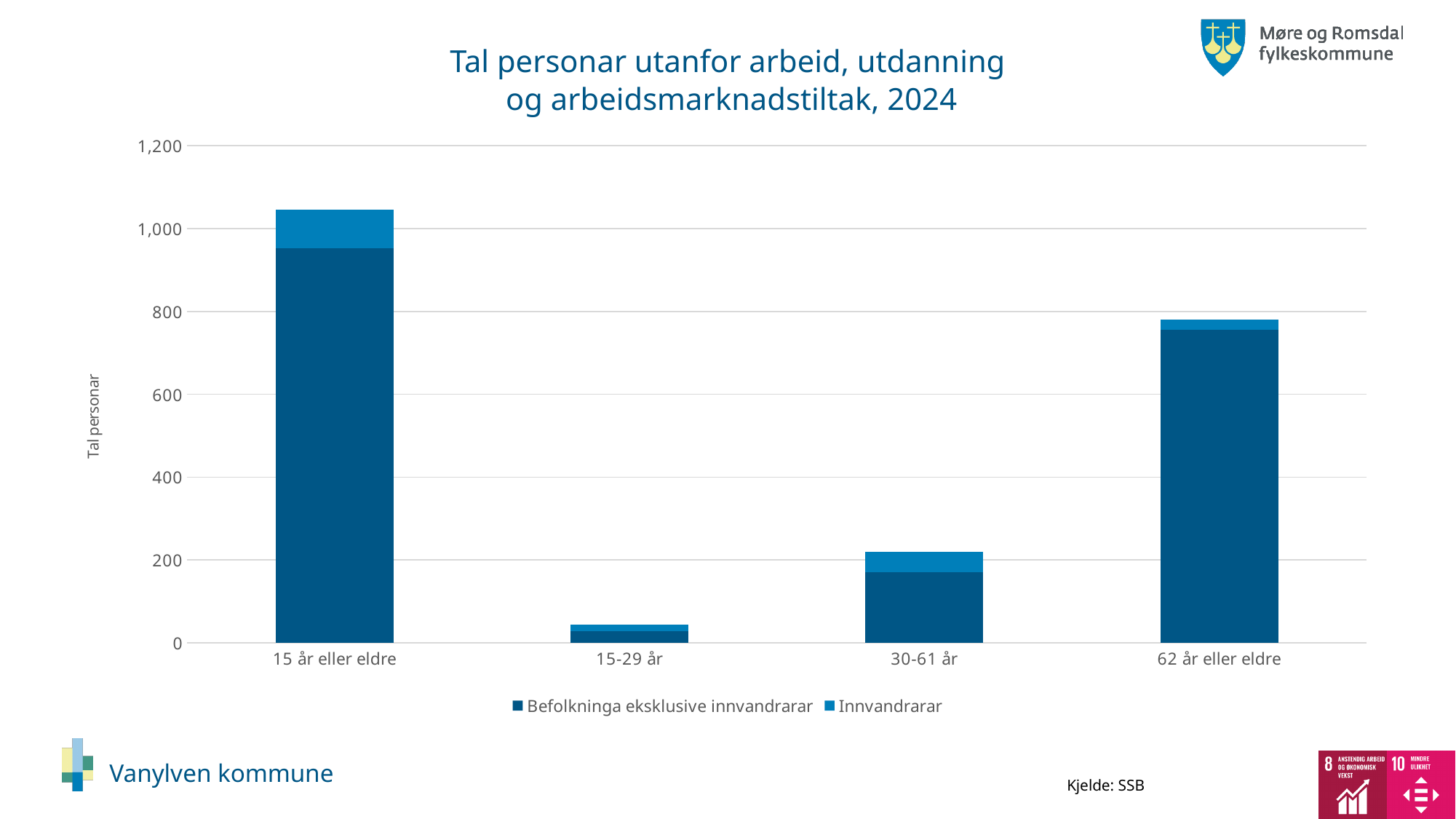
Is the total stacked bar for 15 år eller eldre greater or less than 1,000? greater Is the total stacked bar for 30-61 år greater or less than 200? greater Which category has the tallest stacked bar? 15 år eller eldre What is the title of the chart? Tal personar utanfor arbeid, utdanning og arbeidsmarknadstiltak, 2024 Is the total stacked bar for 15-29 år greater or less than 200? less What is the label of the y axis? Tal personar How many age categories are shown on the x axis? 4 How many series does the legend list? 2 What kind of chart is shown on the slide? Stacked bar chart Which category has the shortest stacked bar? 15-29 år Which has the larger total stacked bar, 62 år eller eldre or 30-61 år? 62 år eller eldre